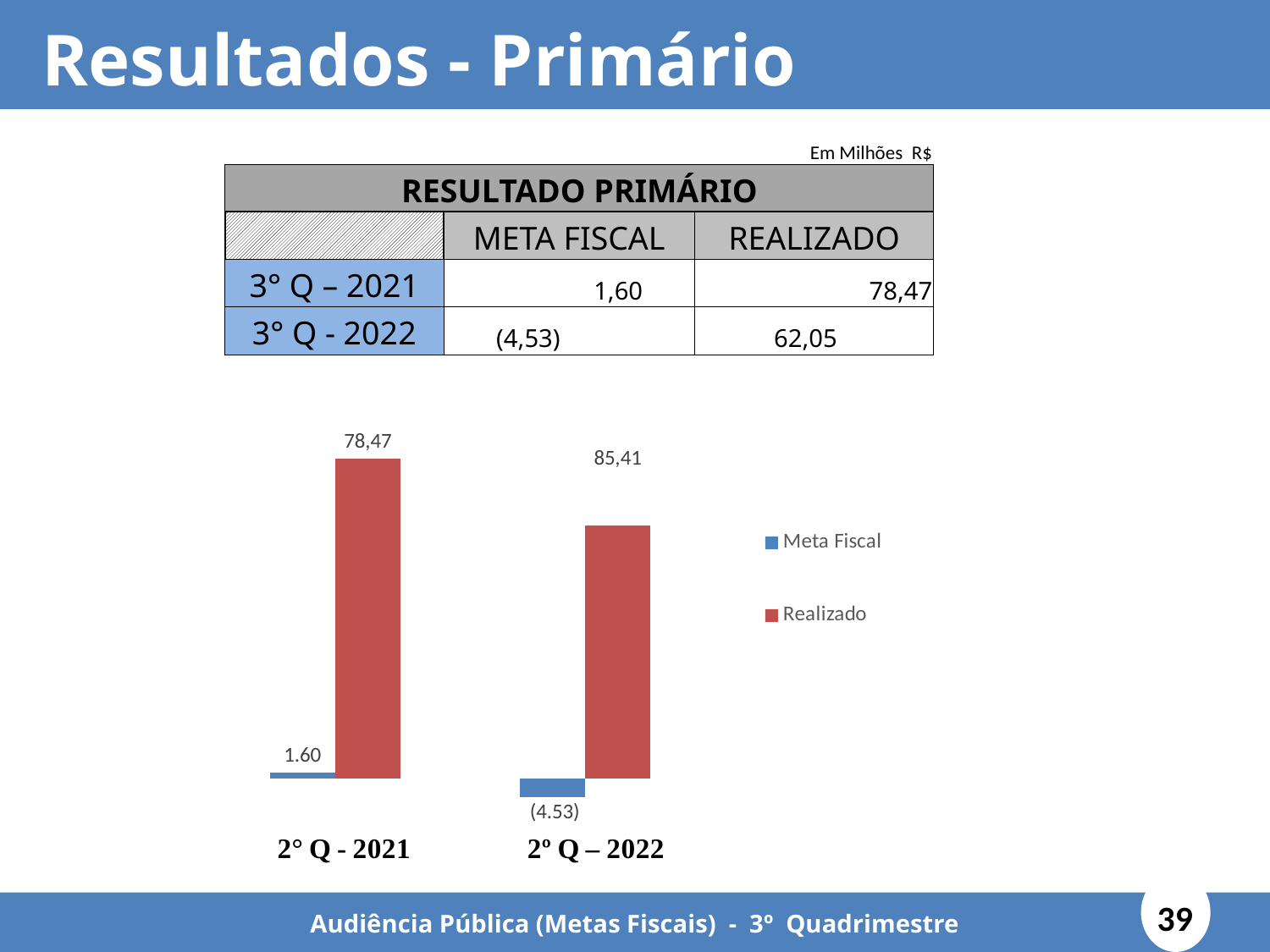
In the chart, which category has the lower Meta Fiscal value? 2º Q – 2022 How many series does the chart legend list? 2 In the chart, is the Realizado value for 2° Q - 2021 larger or smaller than the Realizado value for 2º Q – 2022? larger What kind of chart is shown on the slide? bar chart How many categories are shown on the x axis of the chart? 2 In the chart, which category has the higher Realizado value? 2° Q - 2021 In the chart, what is the Meta Fiscal value for 2º Q – 2022? (4.53) Which series in the chart is drawn in red? Realizado In the chart, what is the Realizado value for 2° Q - 2021? 78,47 In the chart, what is the Meta Fiscal value for 2° Q - 2021? 1.60